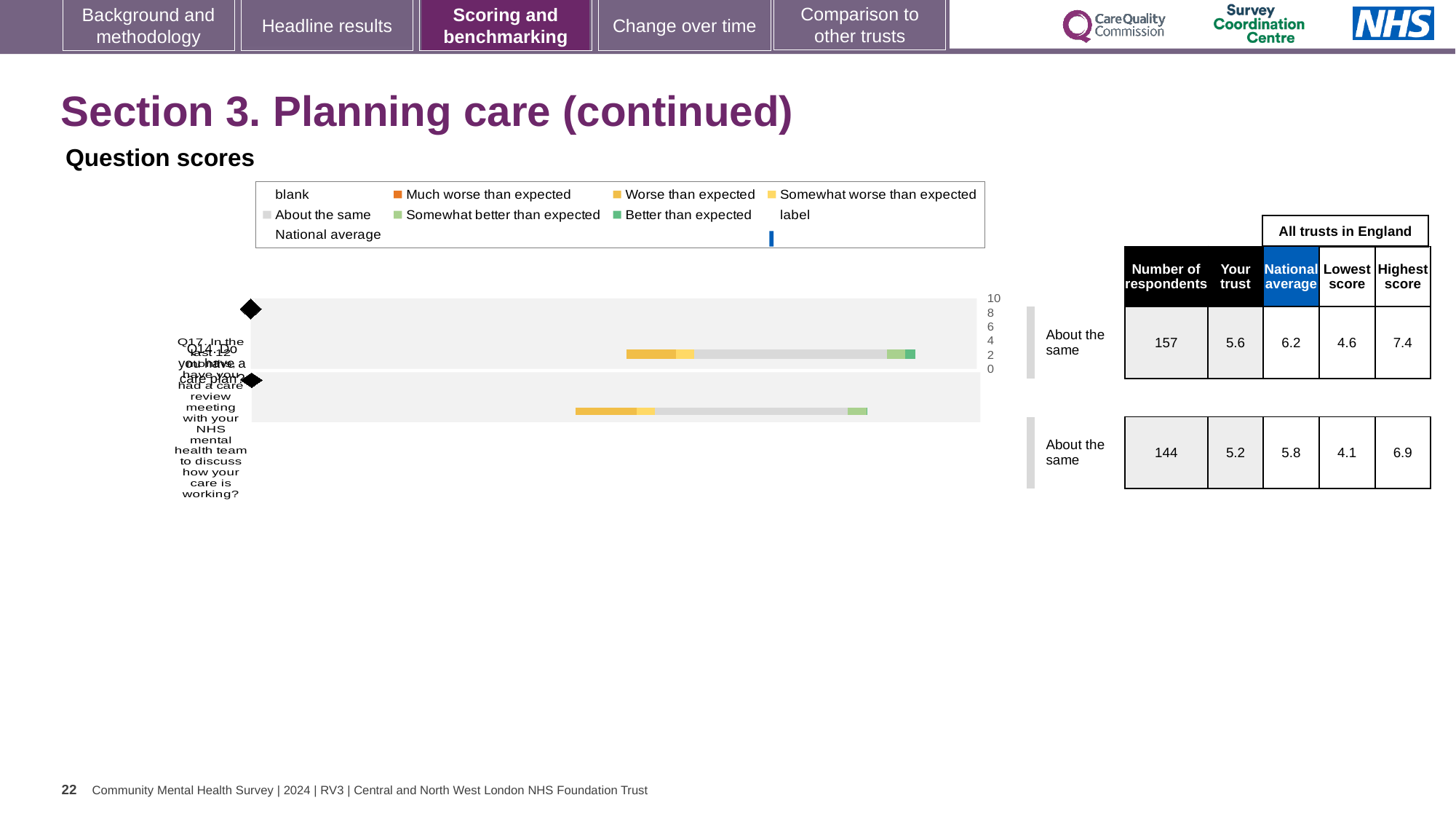
Which row has the higher 'Your trust' score, the top row (Q14) or the bottom row (Q17)? Q14 (top row) What is the highest score among all trusts in England for the top row (Q14)? 7.4 What is the lowest score among all trusts in England for the bottom row (Q17)? 4.1 What is the difference in the number of respondents between the top row (Q14) and the bottom row (Q17)? 13 What kind of chart is used to show the question scores on this slide? bar chart What benchmark category is shown for both rows in the chart? About the same What is the difference between the national average and the 'Your trust' score for the top row (Q14)? 0.6 What is the national average for the top row (Q14)? 6.2 How many question rows are plotted in the question scores chart? 2 What is the number of respondents for the bottom row (Q17)? 144 What is the 'Your trust' score for the bottom row (Q17, care review meeting)? 5.2 What is the 'Your trust' score for the top row (Q14, care plan)? 5.6